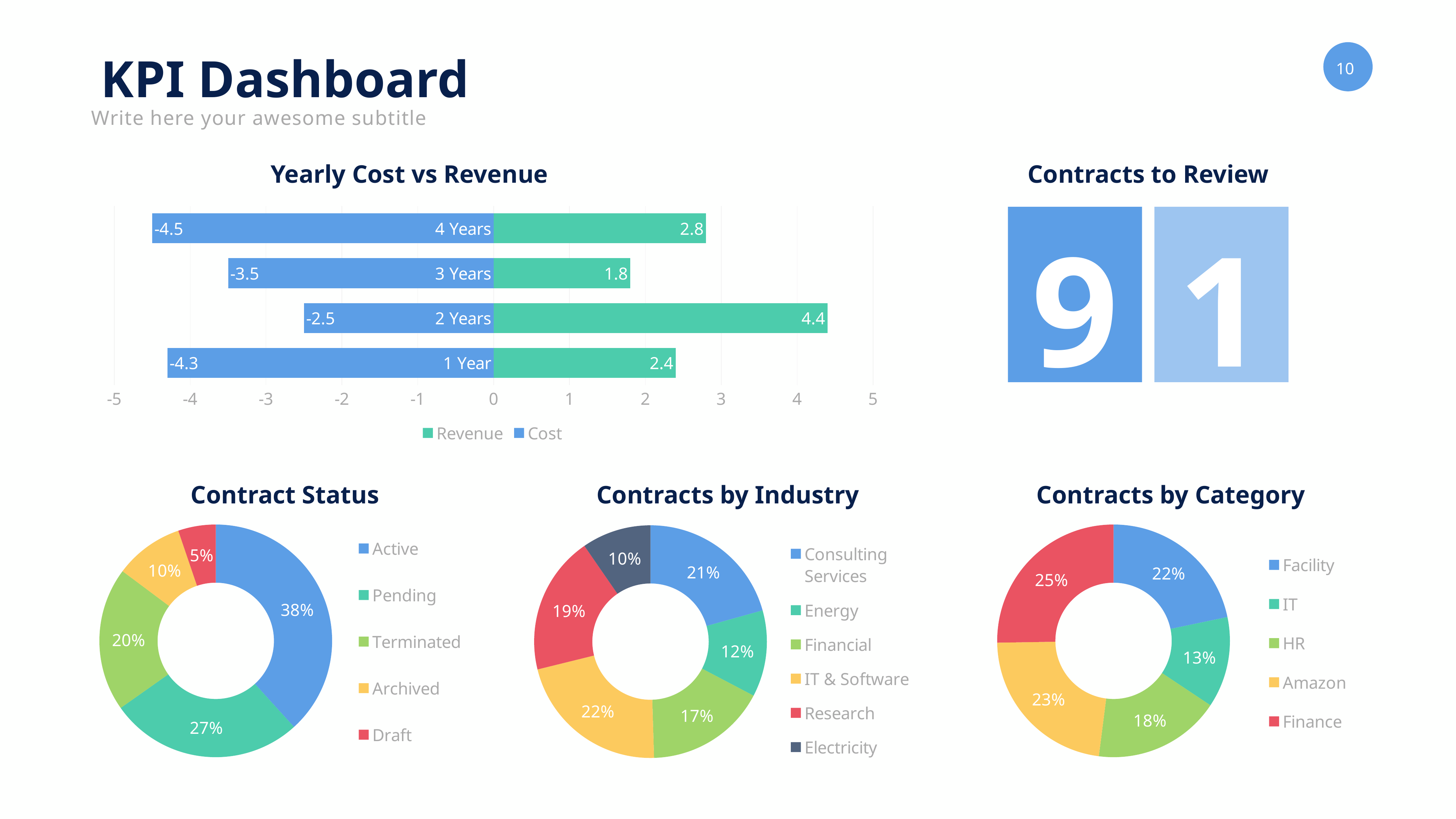
In the Contract Status chart, which status has the smallest share? Draft In the Contracts by Industry chart, how many industries are shown? 6 In the Contracts by Category chart, which category has the largest share? Finance In the Contract Status chart, what share is Pending? 27% In the Contracts by Industry chart, what is the share for IT & Software? 22% What kind of chart is the Yearly Cost vs Revenue chart? Bar chart In the Yearly Cost vs Revenue chart, which category has the highest Revenue? 2 Years In the Yearly Cost vs Revenue chart, what is the difference between the Revenue for 4 Years and the Revenue for 3 Years? 1.0 In the Contracts by Category chart, which is larger, Amazon or HR? Amazon In the Yearly Cost vs Revenue chart, what is the Cost value for 1 Year? -4.3 In the Yearly Cost vs Revenue chart, how many series does the legend list? 2 In the Yearly Cost vs Revenue chart, what is the Revenue value for 2 Years? 4.4